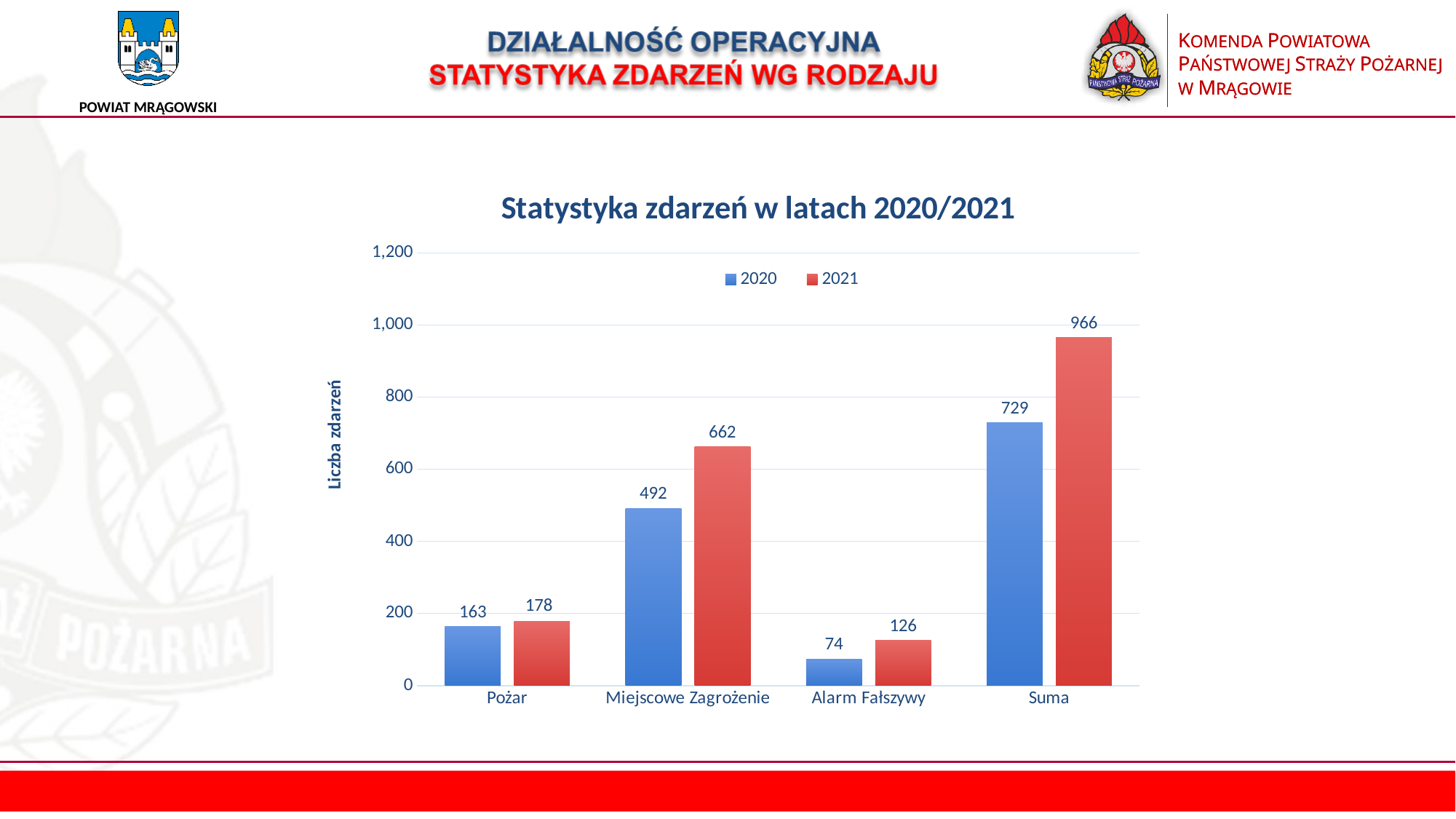
Which category has the highest value in the 2021 series? Suma What is the difference between the 2021 and 2020 values for Miejscowe Zagrożenie? 170 Which is larger for Pożar: the 2020 value or the 2021 value? 2021 How many categories are shown on the x axis? 4 What is the difference between the 2021 and 2020 values for Alarm Fałszywy? 52 What is the value for Suma in the 2021 series? 966 What is the value for Pożar in the 2020 series? 163 What kind of chart is shown on the slide? Bar chart Which category has the lowest value in the 2020 series? Alarm Fałszywy How many series does the legend list? 2 What is the value for Miejscowe Zagrożenie in the 2021 series? 662 What is the value for Alarm Fałszywy in the 2020 series? 74